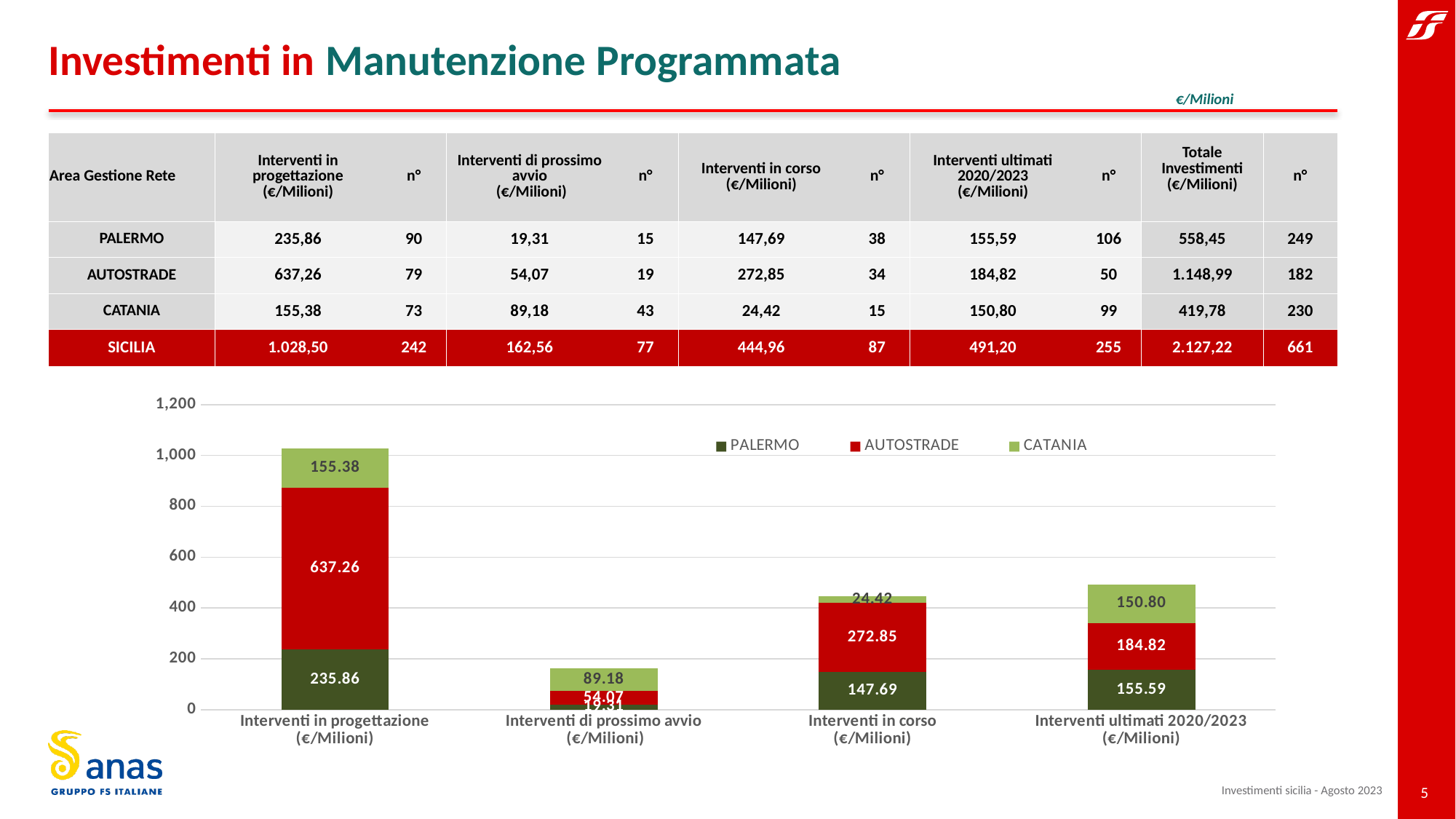
In the 'Interventi di prossimo avvio (€/Milioni)' category, which is larger: the CATANIA value or the AUTOSTRADE value? CATANIA Which colour represents AUTOSTRADE in the chart? red What is the value for CATANIA in the 'Interventi ultimati 2020/2023 (€/Milioni)' category? 150.80 How many series does the chart legend list? 3 Which category has the shortest stacked bar? Interventi di prossimo avvio (€/Milioni) Which category has the tallest stacked bar? Interventi in progettazione (€/Milioni) How many categories are shown along the x axis of the chart? 4 What is the difference between the AUTOSTRADE and PALERMO values in the 'Interventi in corso (€/Milioni)' category? 125.16 What is the value for PALERMO in the 'Interventi in corso (€/Milioni)' category? 147.69 What kind of chart is shown on the slide? stacked bar chart What is the value for AUTOSTRADE in the 'Interventi in progettazione (€/Milioni)' category? 637.26 What is the total of the stacked bar for 'Interventi ultimati 2020/2023 (€/Milioni)'? 491.21